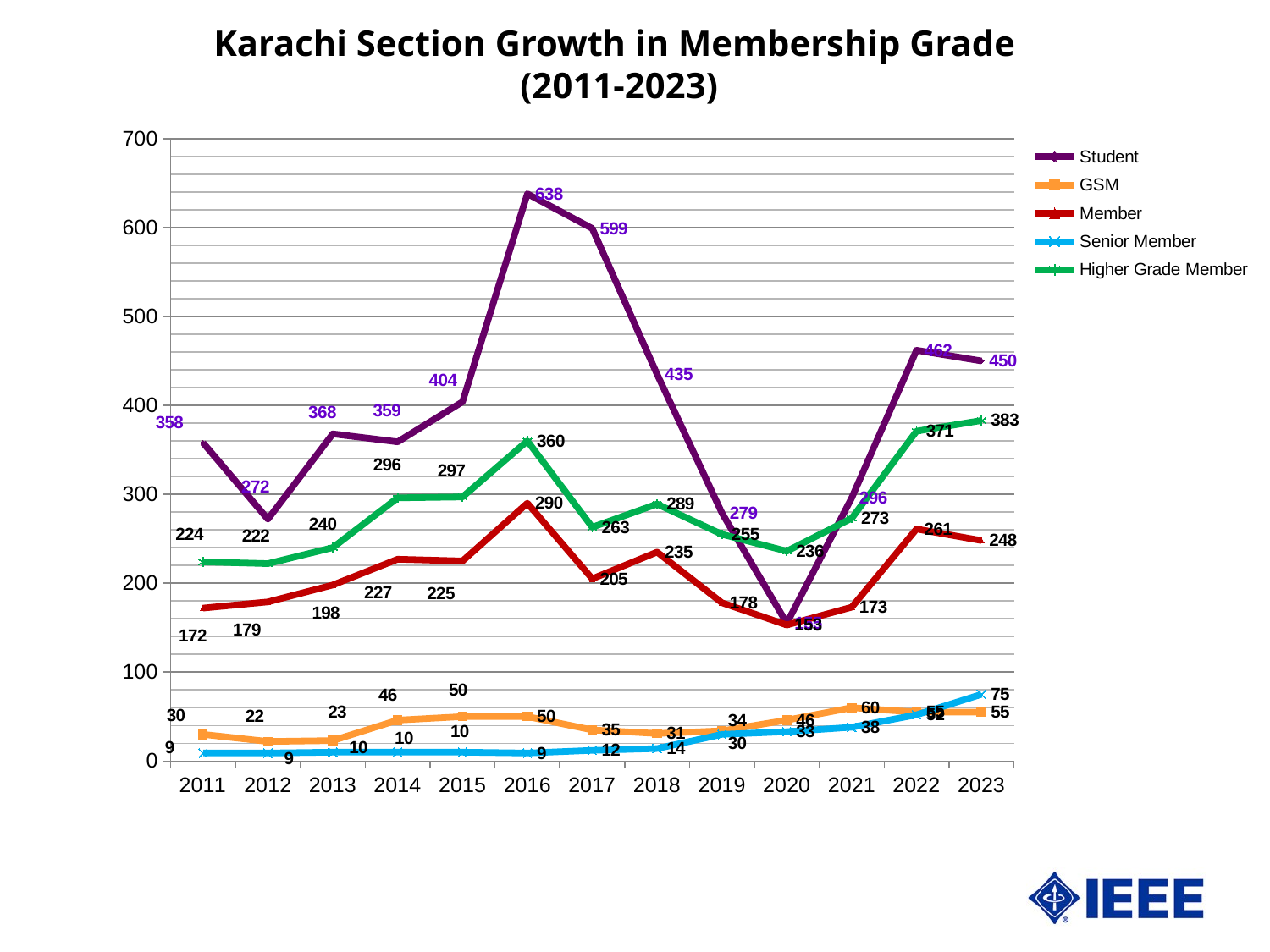
Is the Student value in 2016 greater or less than 600? greater What is the Student value in 2016? 638 In 2022, which is larger: the Member value or the Higher Grade Member value? Higher Grade Member What is the Member value in 2016? 290 How many series does the legend list? 5 What is the Senior Member value in 2023? 75 Does the Senior Member series rise or fall from 2019 to 2023? rise What kind of chart is shown on the slide? line chart What is the difference between the Student values in 2016 and 2017? 39 How many years are plotted along the x axis? 13 What is the Higher Grade Member value in 2023? 383 In which year does the Student series reach its highest value? 2016